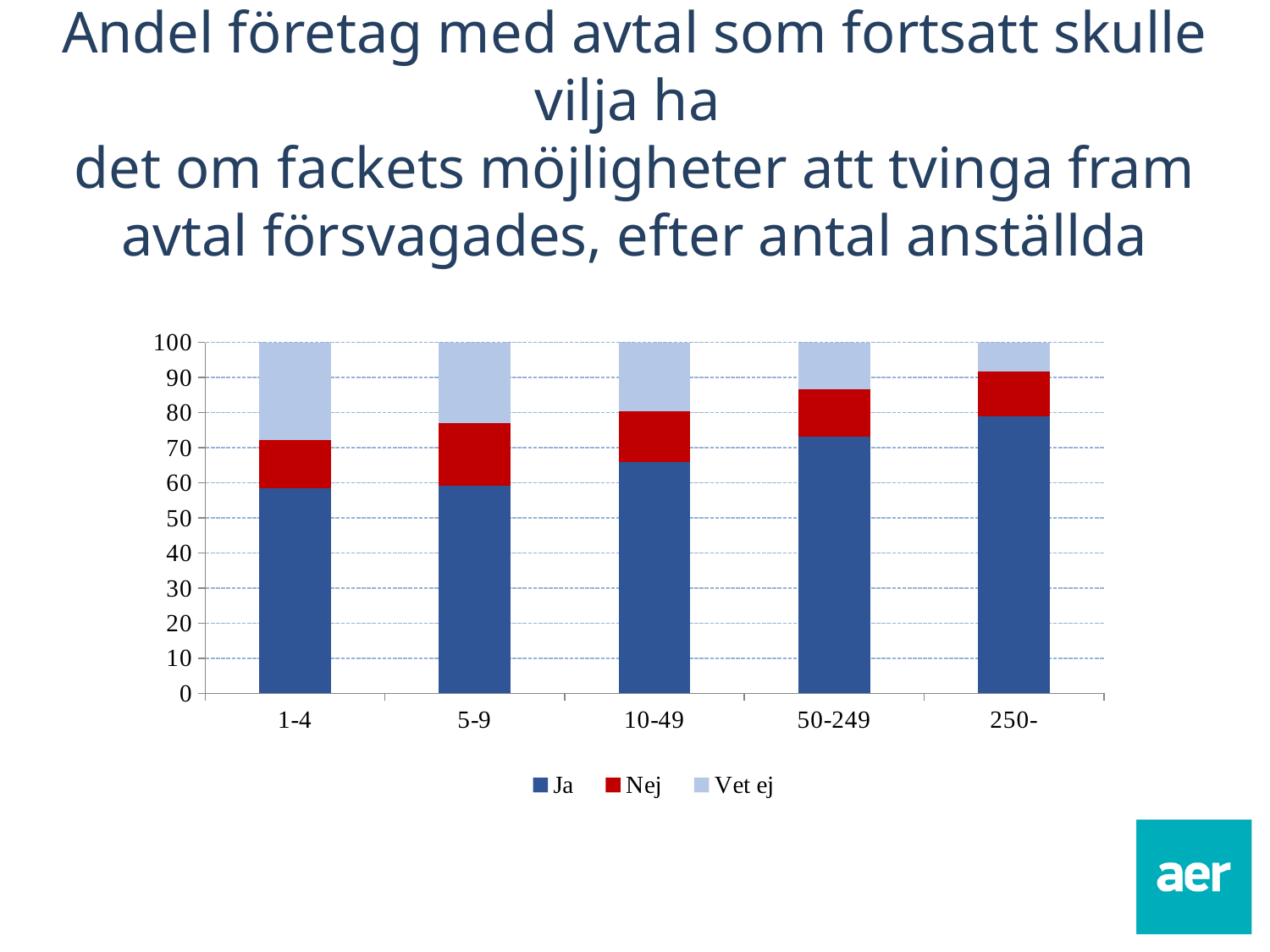
Is the value for Ja in the 5-9 category greater or less than 70? less Does the Ja share rise or fall as company size increases from 1-4 to 250-? Rises What is the total of the stacked bar for the 10-49 category? 100 Which is larger, the Ja value for 50-249 or the Ja value for 10-49? 50-249 Which category has the smallest Vet ej segment? 250- Which category has the highest value for Ja? 250- Is the value for Ja in the 250- category greater or less than 70? greater What kind of chart is shown on the slide? Stacked bar chart How many series does the legend list? 3 How many employee-size categories are shown on the x axis? 5 Is the value for Ja in the 1-4 category greater or less than 50? greater Which category has the largest Vet ej segment? 1-4